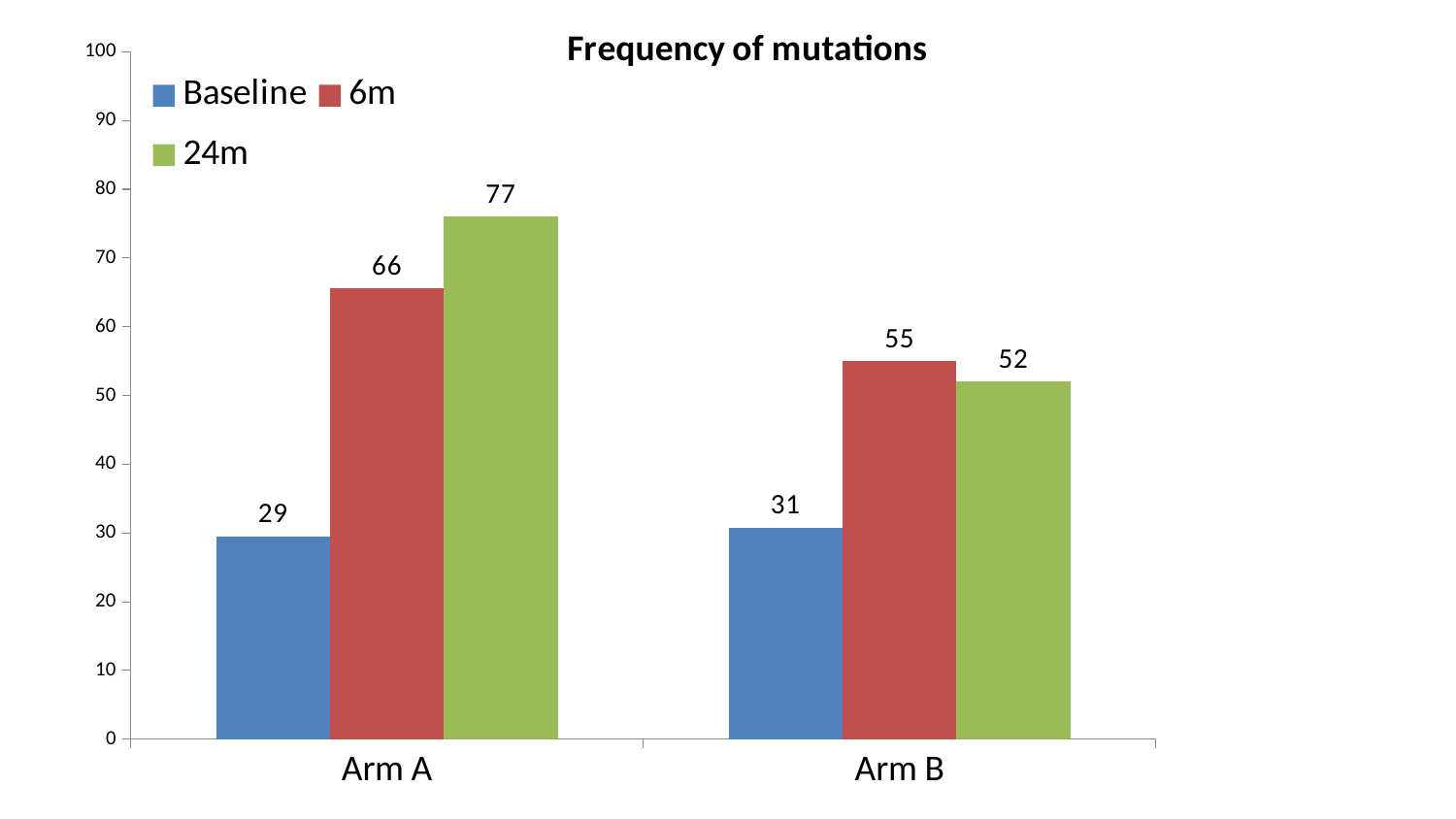
Which is larger, the 6m value for Arm A or the 6m value for Arm B? Arm A What is the title of the chart? Frequency of mutations Is the 24m value for Arm A greater or less than 70? greater What kind of chart is shown? bar chart What is the difference between the 24m values for Arm A and Arm B? 25 How many categories are shown on the x axis? 2 What is the 6m value for Arm A? 66 What is the Baseline value for Arm A? 29 How many series does the legend list? 3 What is the 24m value for Arm B? 52 Which series has the lowest value for Arm B? Baseline Which series has the highest value for Arm A? 24m